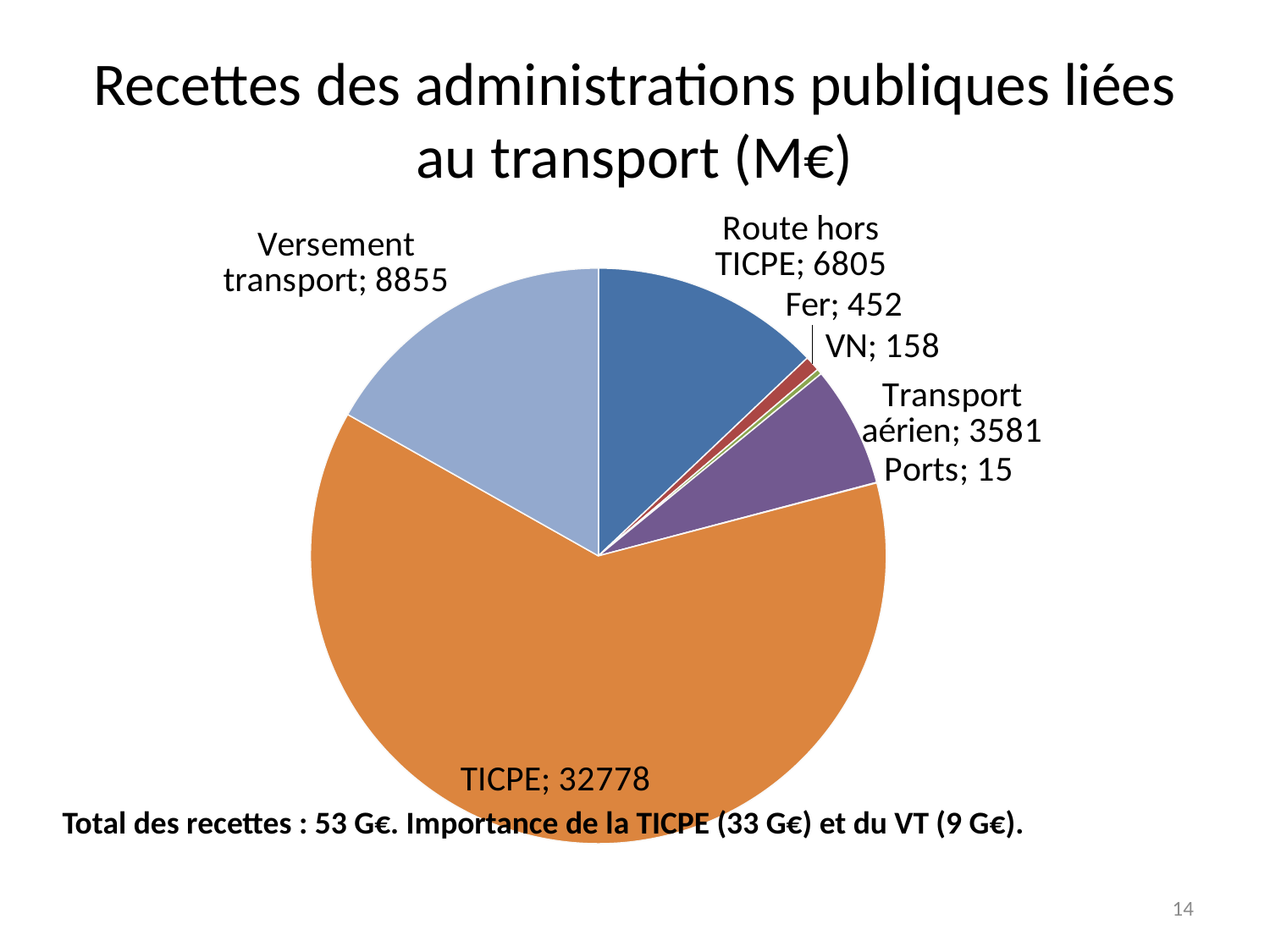
What is the value for Versement transport? 8855 Which is larger, Transport aérien or Route hors TICPE? Route hors TICPE What is the difference between Fer and VN? 294 What is the value for Route hors TICPE? 6805 What is the value for TICPE? 32778 Which category has the smallest value? Ports What is the difference between Versement transport and Route hors TICPE? 2050 How many slices does the pie chart have? 7 Which category has the largest slice of the pie? TICPE What is the value for Transport aérien? 3581 What is the value for Ports? 15 What kind of chart is shown on the slide? pie chart